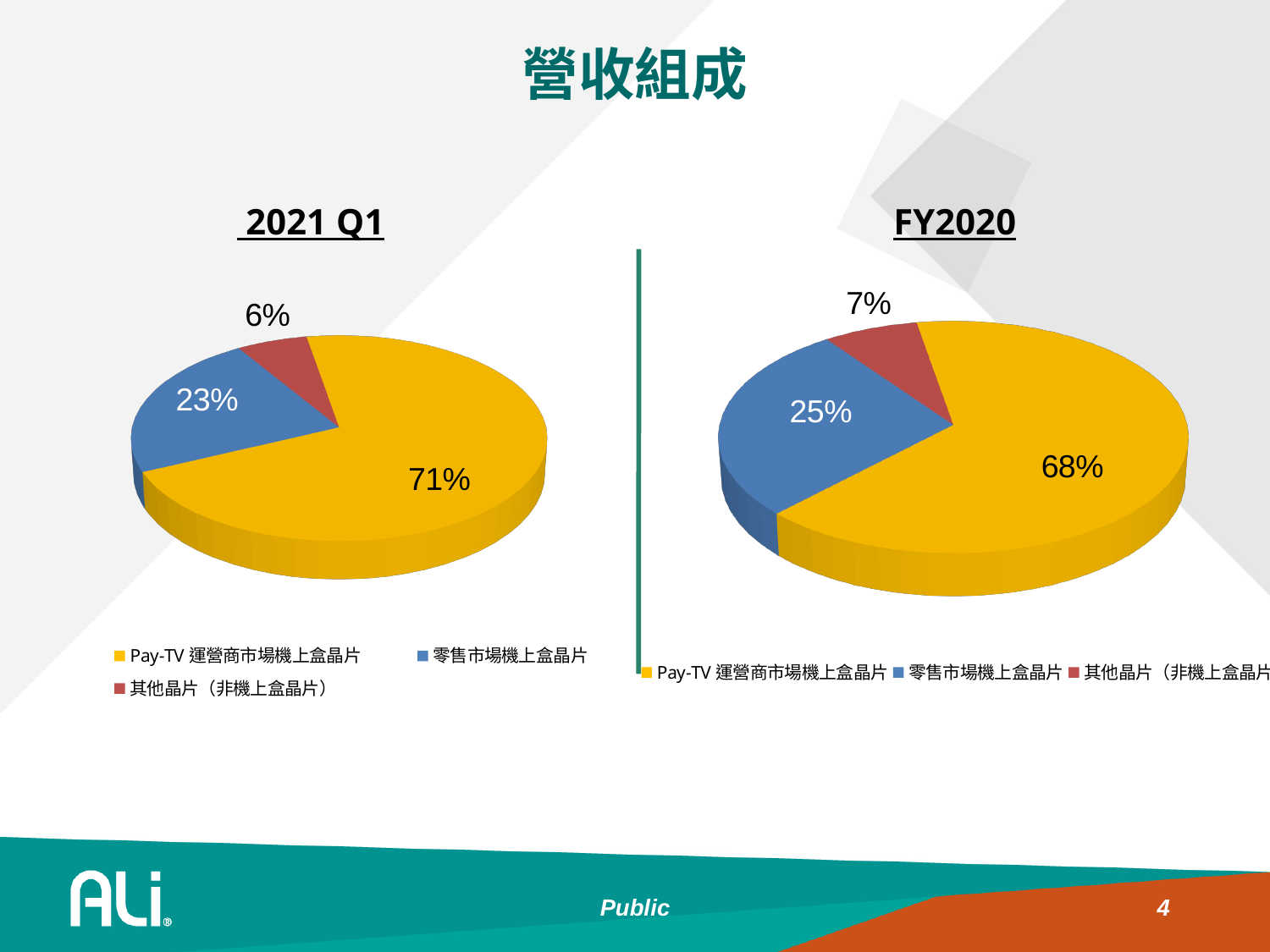
What type of chart is used for FY2020? Pie chart In the 2021 Q1 pie chart, what share does Pay-TV 運營商市場機上盒晶片 have? 71% In the FY2020 pie chart, what share does 其他晶片（非機上盒晶片） have? 7% How many slices does the 2021 Q1 pie chart have? 3 In the FY2020 pie chart, which category has the smallest share? 其他晶片（非機上盒晶片） Is the 零售市場機上盒晶片 share larger in 2021 Q1 or in FY2020? FY2020 What is the difference between the Pay-TV 運營商市場機上盒晶片 share in 2021 Q1 and in FY2020? 3% In the 2021 Q1 pie chart, what share does 零售市場機上盒晶片 have? 23% In the 2021 Q1 pie chart, which category has the largest share? Pay-TV 運營商市場機上盒晶片